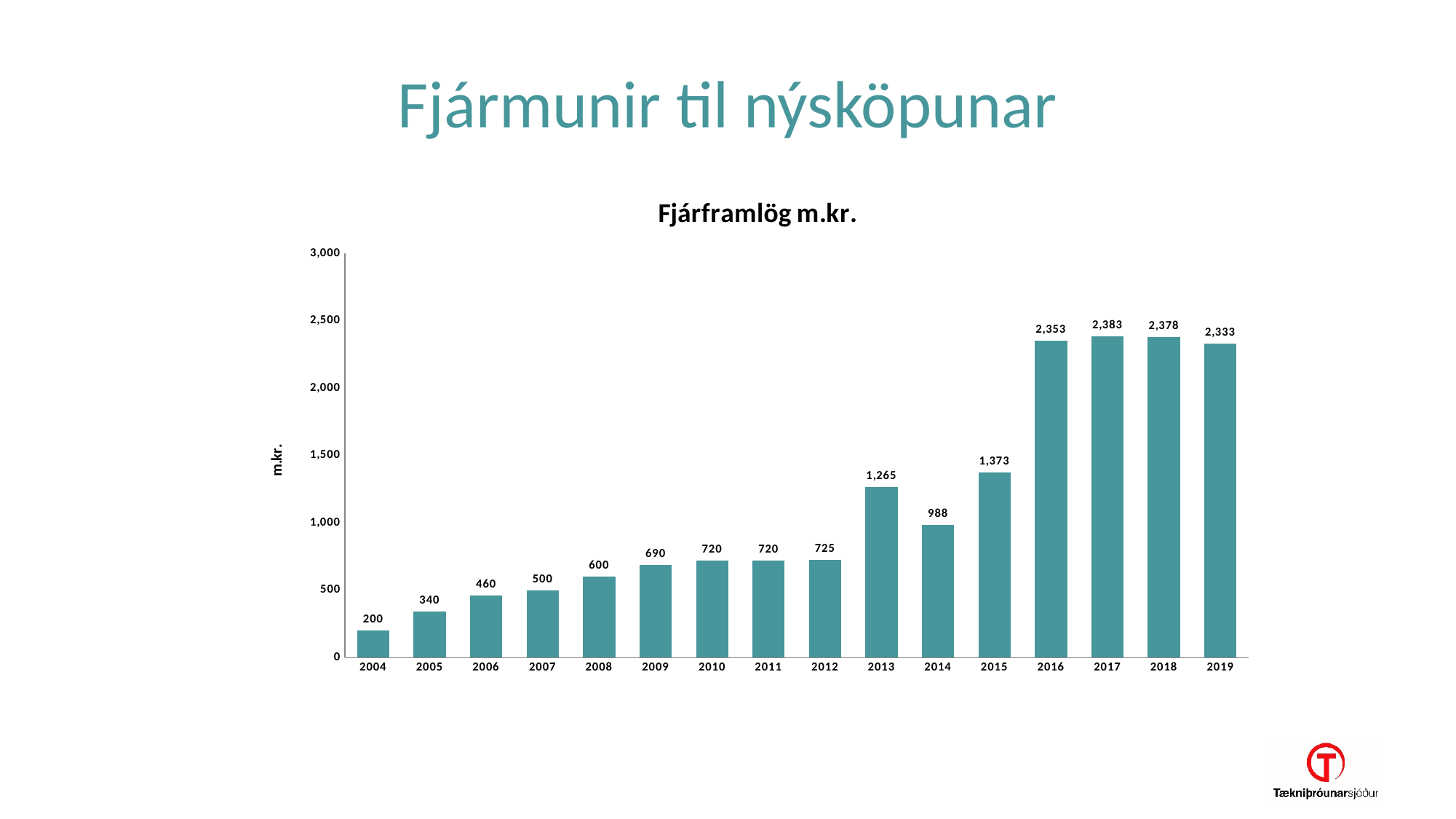
What is the value for 2013? 1,265 What kind of chart is shown? bar chart What is the value for 2017? 2,383 What is the value for 2004? 200 How many years are shown on the x axis? 16 What is the difference between the values for 2015 and 2014? 385 Which year has the lowest value? 2004 Which is larger, the value for 2013 or the value for 2014? 2013 What is the title of the chart? Fjárframlög m.kr. Which year has the highest value? 2017 Is the value for 2016 greater or less than 2,000? greater Do the values generally rise or fall from 2004 to 2019? rise